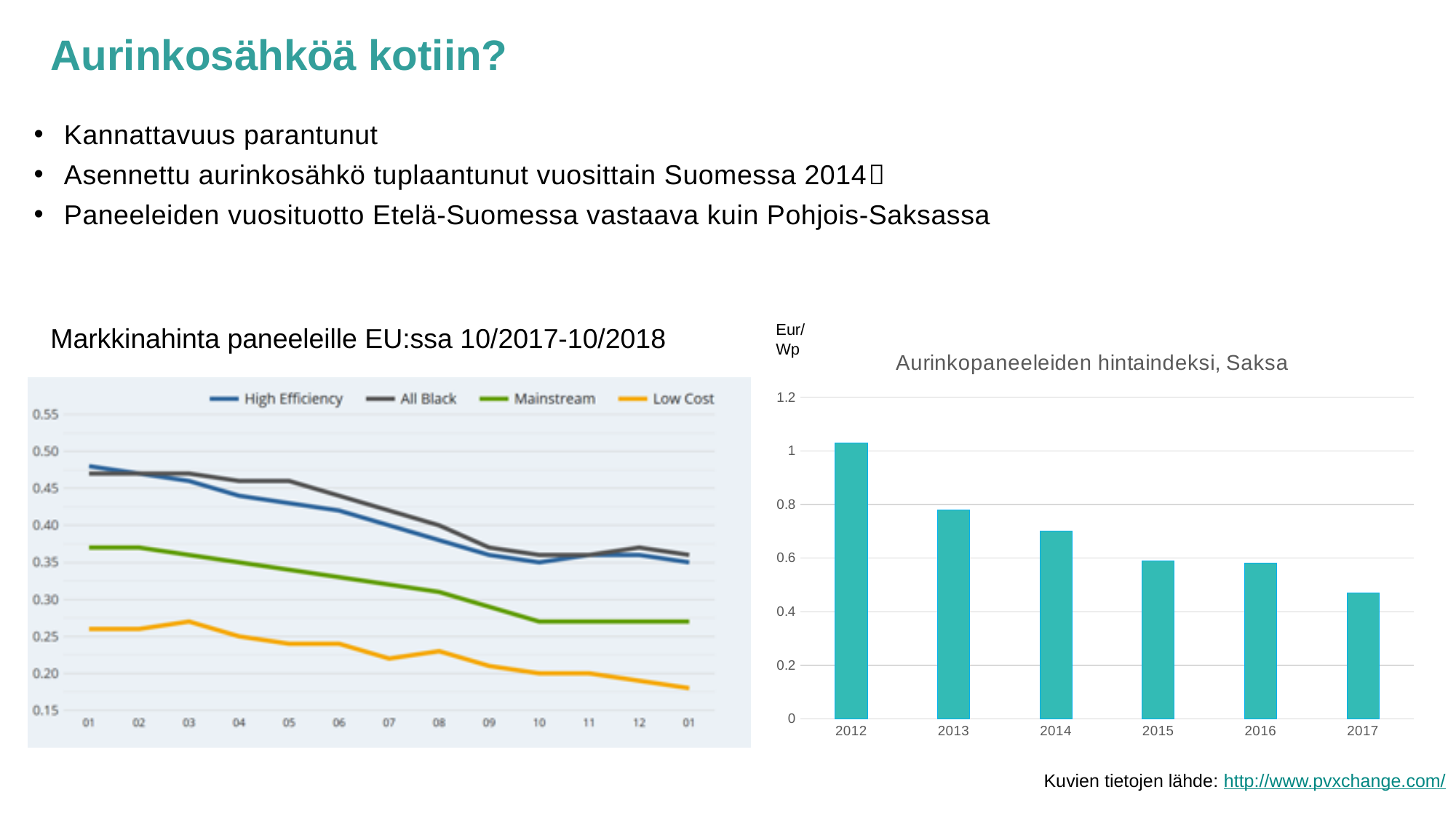
In the chart "Markkinahinta paneeleille EU:ssa 10/2017-10/2018", how many series does the legend list? 4 In the chart "Markkinahinta paneeleille EU:ssa 10/2017-10/2018", which series is shown in green? Mainstream What kind of chart is the chart titled "Aurinkopaneeleiden hintaindeksi, Saksa"? bar chart In the chart "Markkinahinta paneeleille EU:ssa 10/2017-10/2018", which series has the lowest values throughout? Low Cost In the chart "Aurinkopaneeleiden hintaindeksi, Saksa", is the value for 2014 greater or less than 0.8? less In the chart "Aurinkopaneeleiden hintaindeksi, Saksa", do the values rise or fall from 2012 to 2017? fall In the chart "Markkinahinta paneeleille EU:ssa 10/2017-10/2018", is the Low Cost value at the last point (01) greater or less than 0.20? less In the chart "Aurinkopaneeleiden hintaindeksi, Saksa", which year has the lowest value? 2017 In the chart "Aurinkopaneeleiden hintaindeksi, Saksa", is the value for 2017 greater or less than 0.6? less What kind of chart is the chart titled "Markkinahinta paneeleille EU:ssa 10/2017-10/2018"? line chart In the chart "Aurinkopaneeleiden hintaindeksi, Saksa", which year has the highest value? 2012 In the chart "Aurinkopaneeleiden hintaindeksi, Saksa", how many years are shown on the x axis? 6